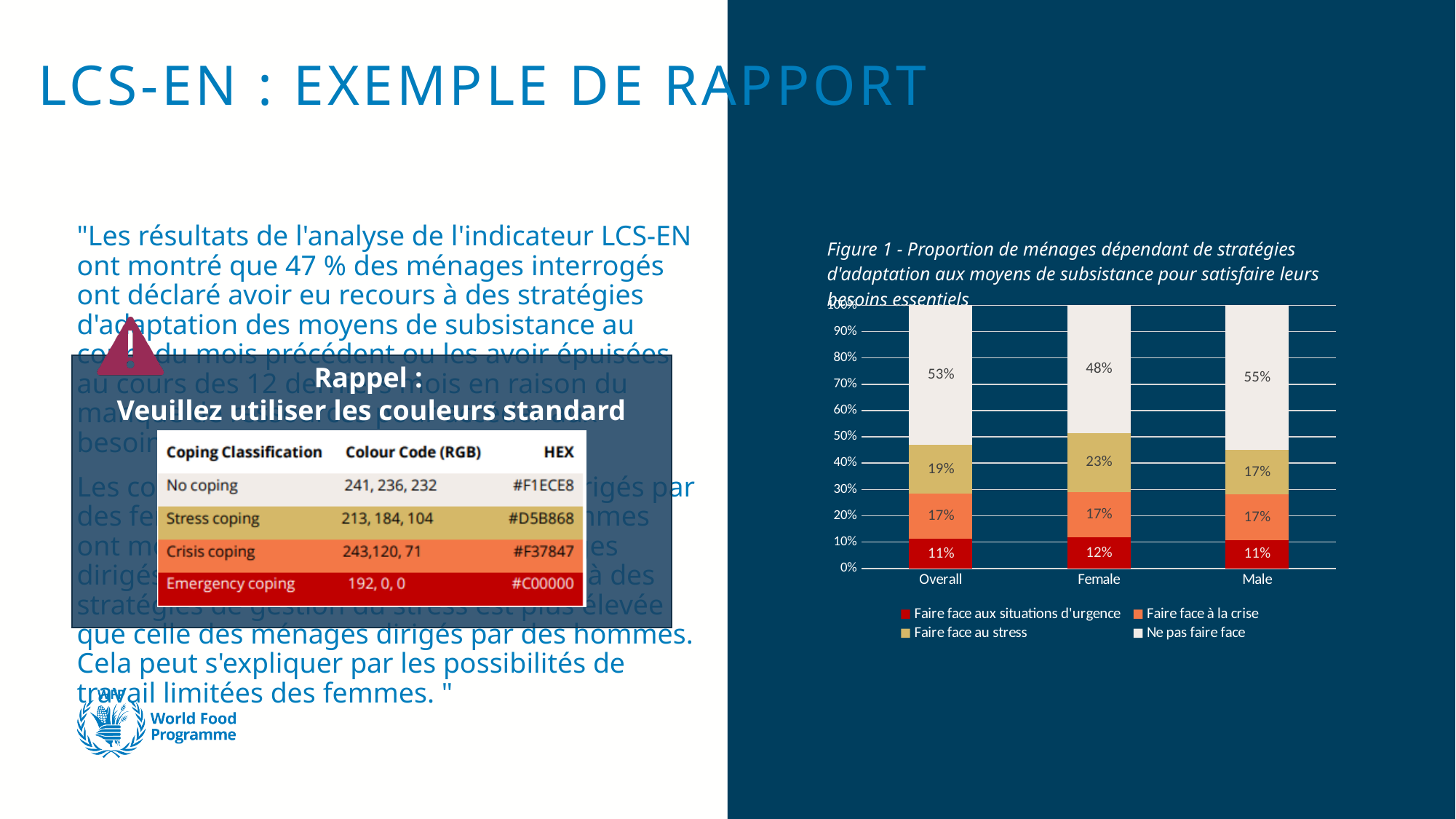
Which category has the lowest value for 'Faire face au stress'? Male How many categories are shown on the x axis of the chart? 3 What is the value of 'Faire face à la crise' for Overall? 17% How many series does the chart's legend list? 4 Which series is shown in red in the chart's legend? Faire face aux situations d'urgence What kind of chart is shown on the slide? Stacked bar chart What is the value of 'Faire face au stress' for Female? 23% What is the value of 'Ne pas faire face' for Female? 48% Is the 'Faire face au stress' value larger for Female or for Male? Female What is the value of 'Faire face aux situations d'urgence' for Male? 11% Which category has the highest value for 'Ne pas faire face'? Male What is the difference between the 'Ne pas faire face' values for Male and Female? 7%